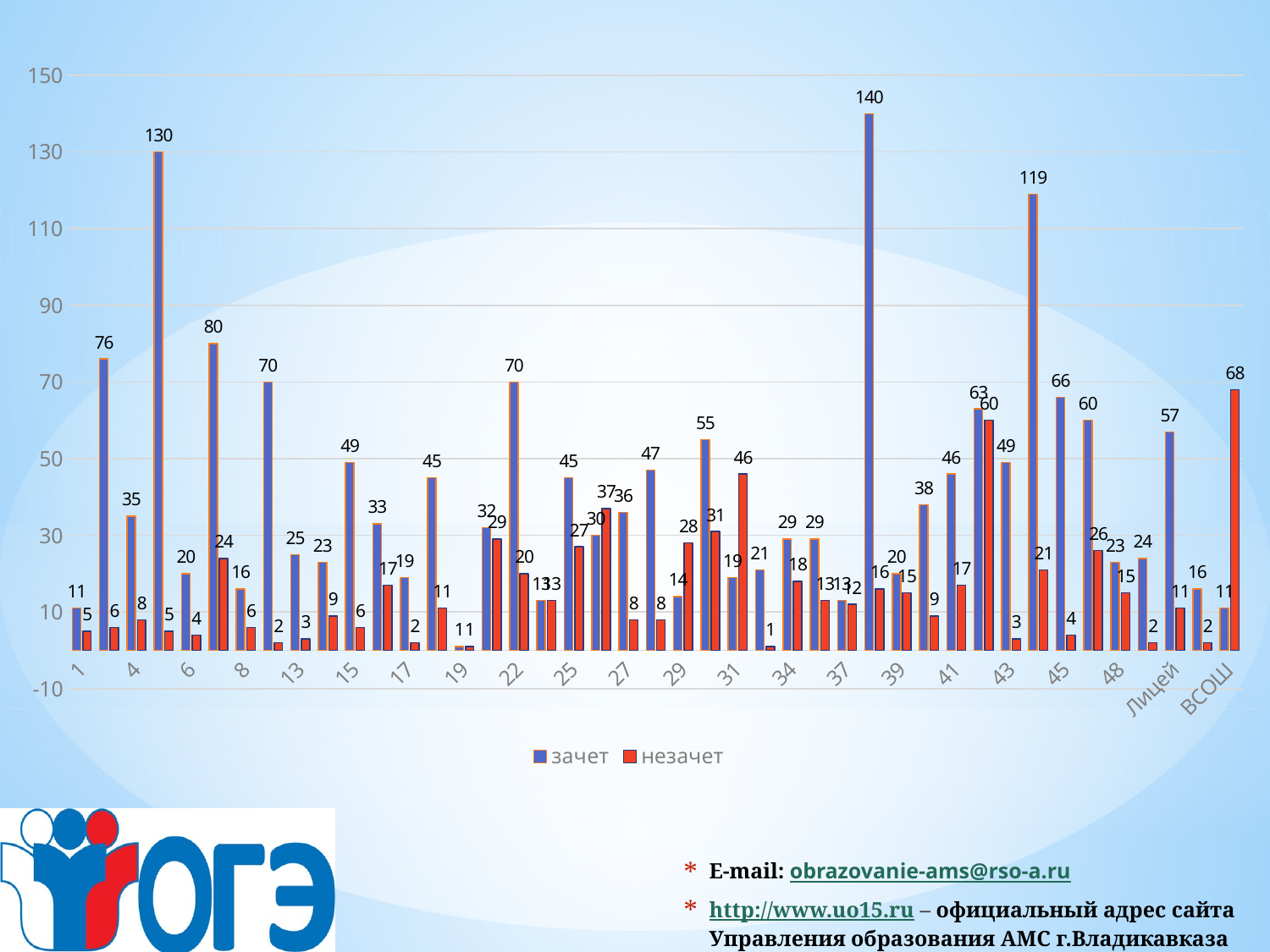
What is the незачет value for category 22? 20 For category 31, which is larger: зачет or незачет? незачет What type of chart is shown on the slide? bar chart What is the незачет value for ВСОШ? 68 What is the зачет value for ВСОШ? 11 What is the total of зачет and незачет for category 1? 16 Which category has the highest незачет value? ВСОШ What is the highest value in the зачет series? 140 What is the difference between the зачет and незачет values for category 45? 62 What is the зачет value for Лицей? 57 What are the two series named in the legend? зачет and незачет How many series does the legend list? 2